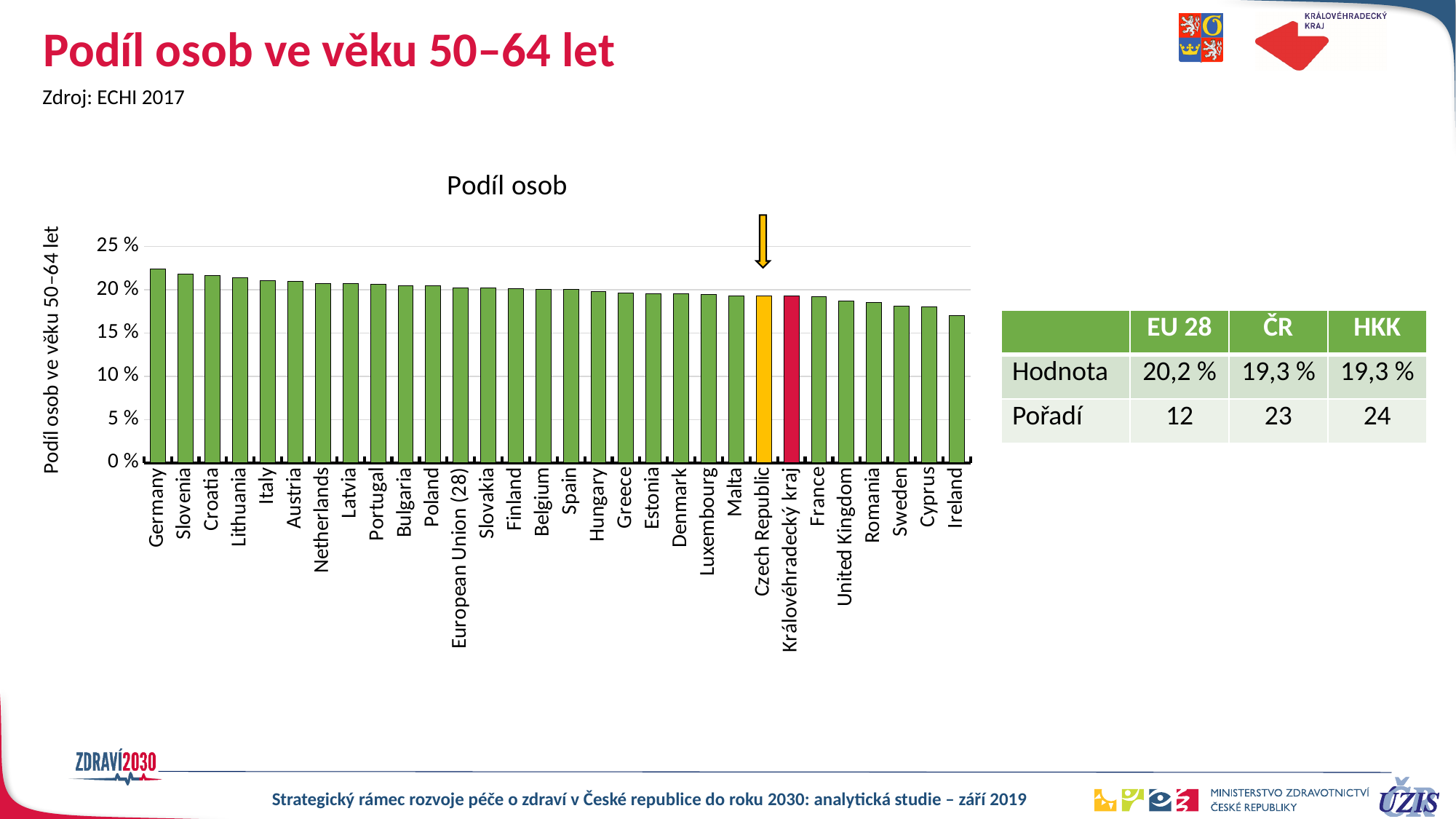
Which country has the highest share of persons aged 50–64 in the chart? Germany Which is larger, the value for Germany or the value for Ireland? Germany What is the title of the chart? Podíl osob How many bars (categories) are plotted in the chart? 30 Is the value for Ireland greater or less than 20 %? less Is the value for Germany greater or less than 20 %? greater What is the value for Czech Republic (ČR) according to the table on the slide? 19,3 % What is the value for European Union (28) according to the table on the slide? 20,2 % Which country has the lowest share of persons aged 50–64 in the chart? Ireland Do the bar values rise or fall from left to right along the x axis? fall What type of chart is shown on the slide? bar chart What is the value for Královéhradecký kraj (HKK) according to the table on the slide? 19,3 %